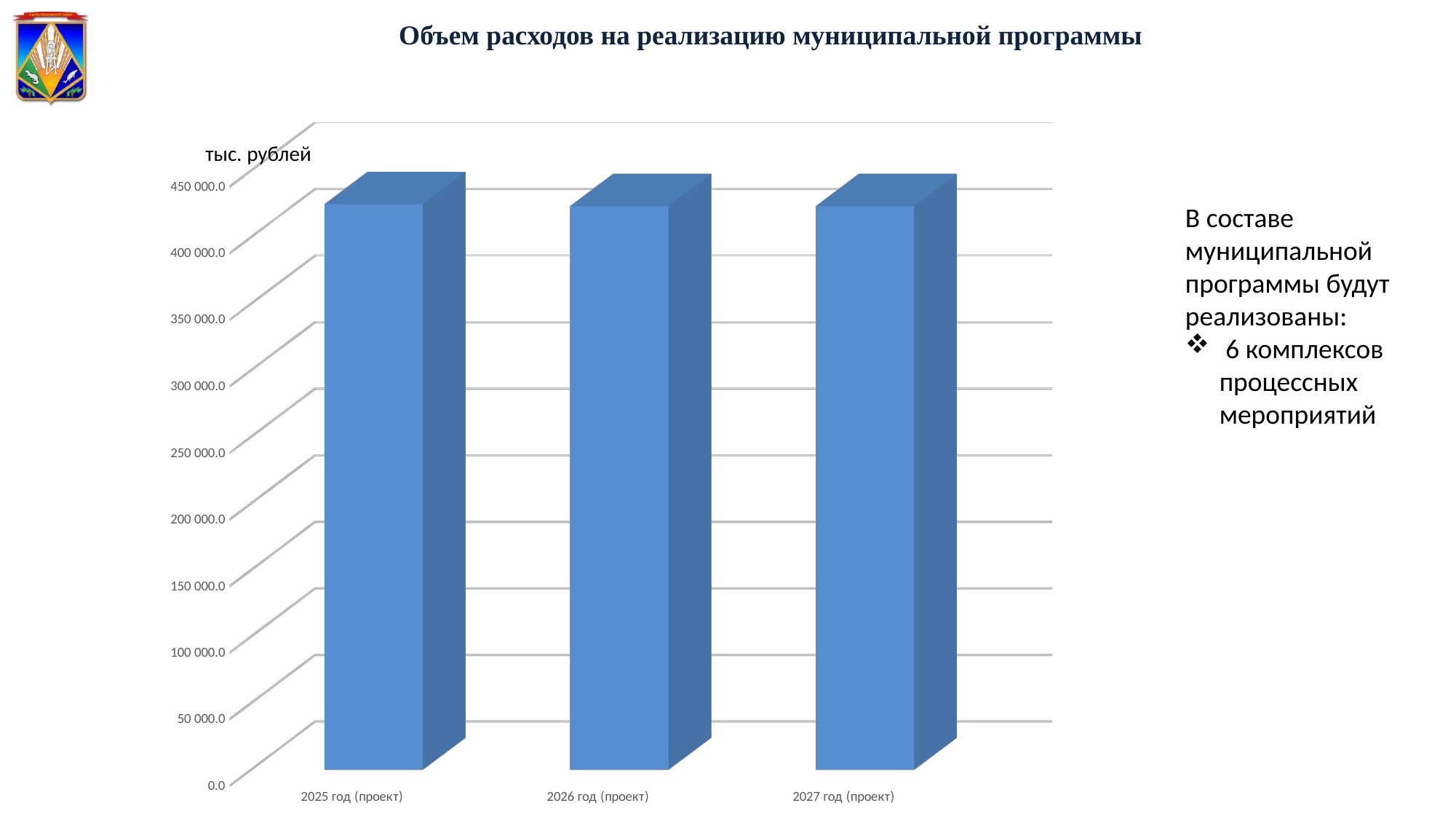
Is the value for 2025 год (проект) greater or less than 400 000.0? greater What unit is indicated for the values on the chart's vertical axis? тыс. рублей What kind of chart is shown on the slide? Bar chart Is the value for 2027 год (проект) greater or less than 450 000.0? less Is the value for 2026 год (проект) greater or less than 400 000.0? greater How many bars (categories) does the chart show? 3 What is the label of the first category on the x axis? 2025 год (проект) What is the title of the chart on the slide? Объем расходов на реализацию муниципальной программы